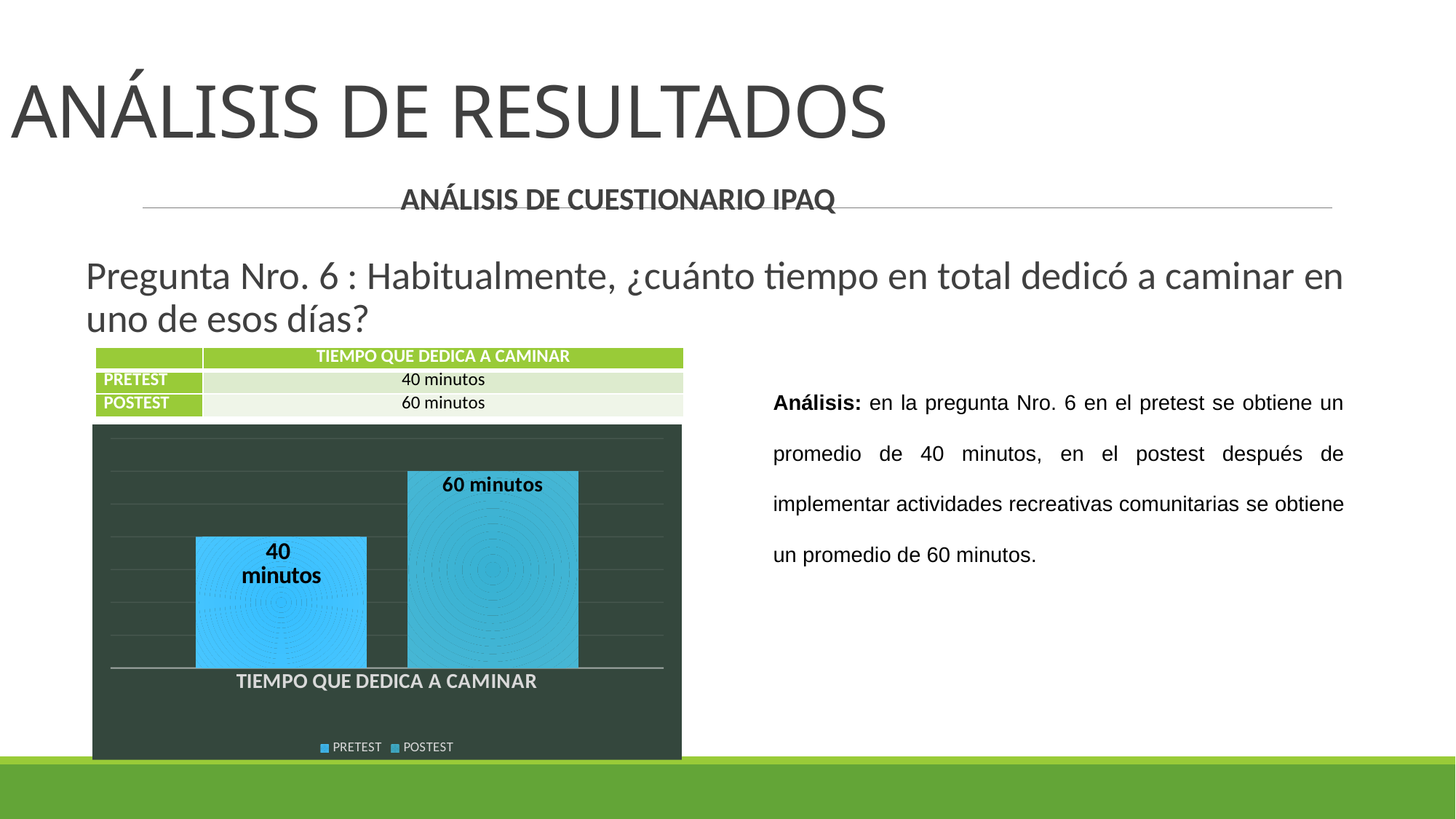
Which series has the higher value, PRETEST or POSTEST? POSTEST What is the value for PRETEST in the chart? 40 minutos What is the value for POSTEST in the chart? 60 minutos What are the two legend entries of the chart? PRETEST and POSTEST Which series has the highest value in the chart? POSTEST What kind of chart is shown on the slide? Bar chart What is the category label shown on the x axis of the chart? TIEMPO QUE DEDICA A CAMINAR How many series does the chart legend list? 2 How many bars are plotted in the chart? 2 What is the difference in minutes between the POSTEST and PRETEST values? 20 minutos Which series has the lowest value in the chart? PRETEST